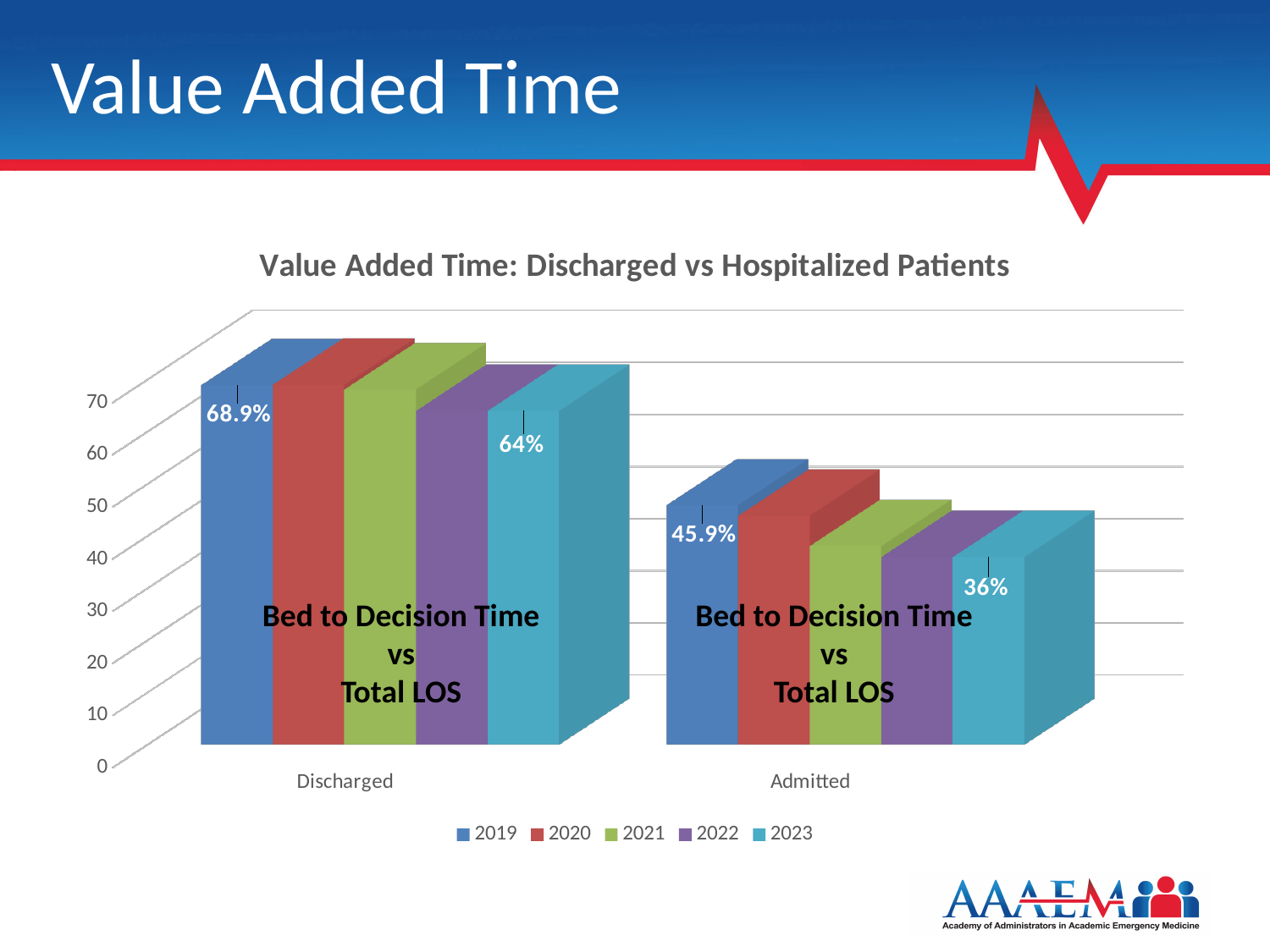
What is the difference between the 2019 and 2023 values in the Admitted category? 9.9 percentage points What is the difference between the 2019 values for Discharged and Admitted? 23 percentage points What is the value for 2023 in the Admitted category? 36% Is the 2023 value for Admitted greater or less than 50? less Is the 2019 value for Discharged greater or less than 60? greater What is the value for 2023 in the Discharged category? 64% What is the title of the chart? Value Added Time: Discharged vs Hospitalized Patients Which is larger, the 2019 value for Discharged or the 2019 value for Admitted? Discharged How many categories are shown on the x axis? 2 What is the value for 2019 in the Admitted category? 45.9% How many series does the legend list? 5 What is the value for 2019 in the Discharged category? 68.9%